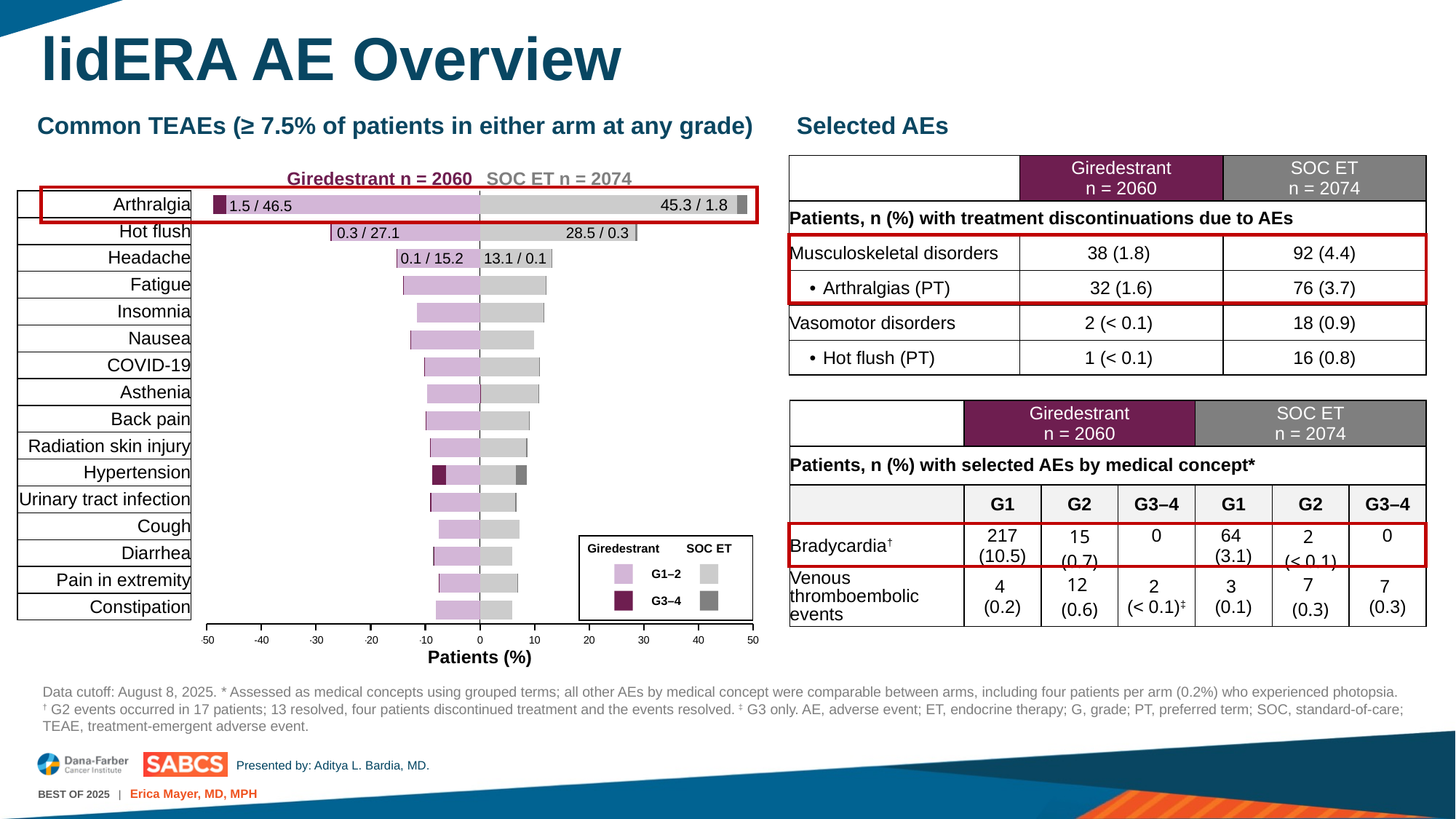
In the Common TEAEs chart, what is the difference between the SOC ET and Giredestrant G1–2 percentages for Hot flush? 1.4 In the Common TEAEs chart, which adverse event has the highest G1–2 percentage in the Giredestrant arm? Arthralgia In the Common TEAEs chart, what is the G3–4 percentage for Hot flush in the Giredestrant arm? 0.3 In the Common TEAEs chart, what is the G1–2 percentage for Arthralgia in the SOC ET arm? 45.3 In the Common TEAEs chart, which arm has the higher G1–2 percentage for Headache, Giredestrant or SOC ET? Giredestrant What type of chart is the Common TEAEs chart? Bar chart In the Common TEAEs chart, is the G1–2 value for Fatigue in the Giredestrant arm greater or less than 10? greater How many entries does the legend of the Common TEAEs chart list? 4 What is the x-axis title of the Common TEAEs chart? Patients (%) In the Common TEAEs chart, what is the G1–2 percentage for Headache in the SOC ET arm? 13.1 How many adverse event categories are listed in the Common TEAEs chart? 16 In the Common TEAEs chart, what is the G1–2 percentage for Arthralgia in the Giredestrant arm? 46.5